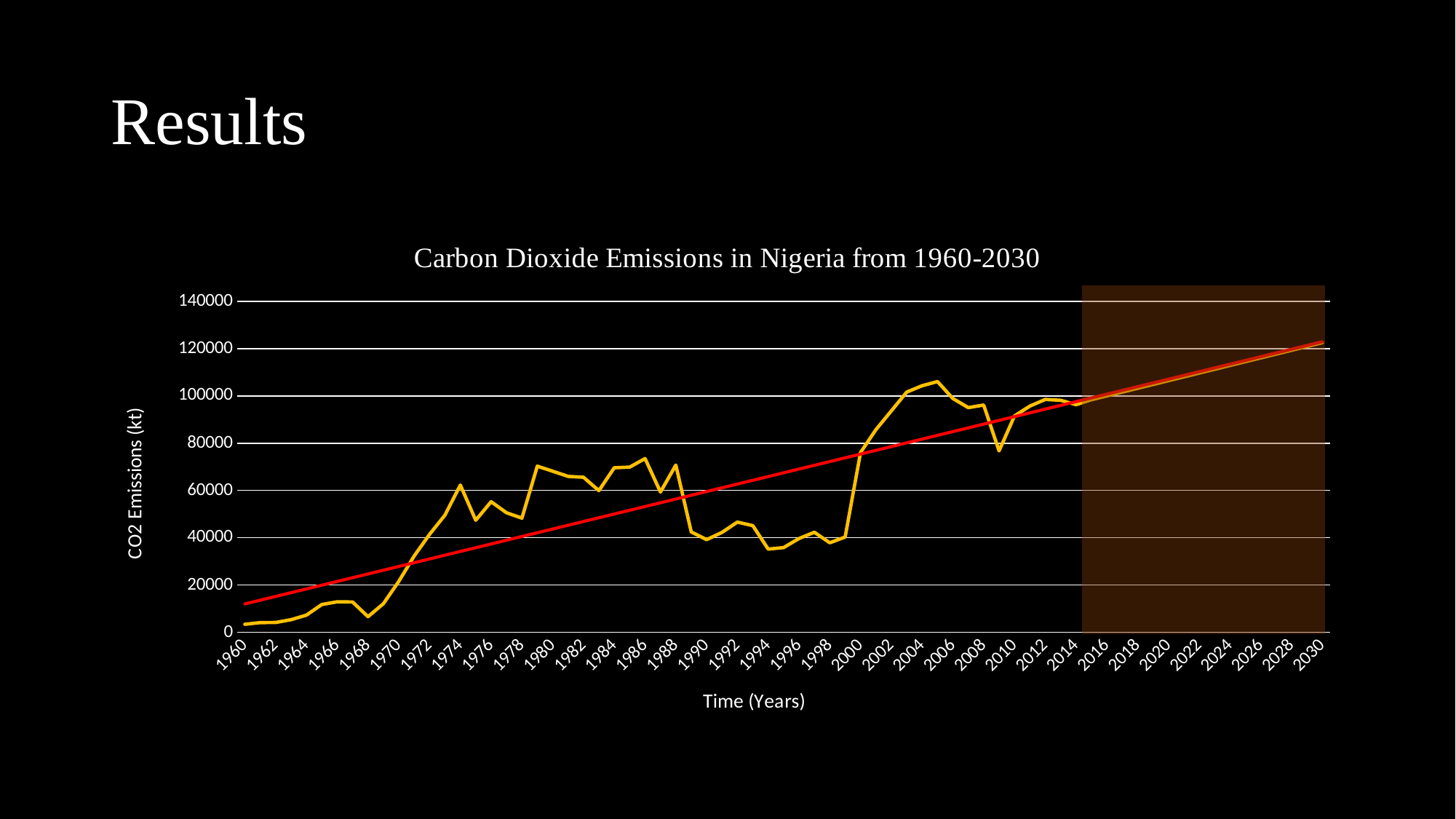
What is the label on the vertical axis of the chart? CO2 Emissions (kt) Is the value of the yellow line for 1980 greater or less than 60000? greater Is the value of the yellow line for 2004 greater or less than 100000? greater Is the value of the red trend line at 2030 greater or less than 100000? greater What kind of chart is shown on the slide? Line chart How many year labels are shown along the x axis? 36 Which year has the higher CO2 emissions value on the yellow line, 1970 or 1980? 1980 Which year has the higher CO2 emissions value on the yellow line, 1984 or 2004? 2004 What is the title of the chart? Carbon Dioxide Emissions in Nigeria from 1960-2030 Does the red trend line rise or fall from 1960 to 2030? Rises